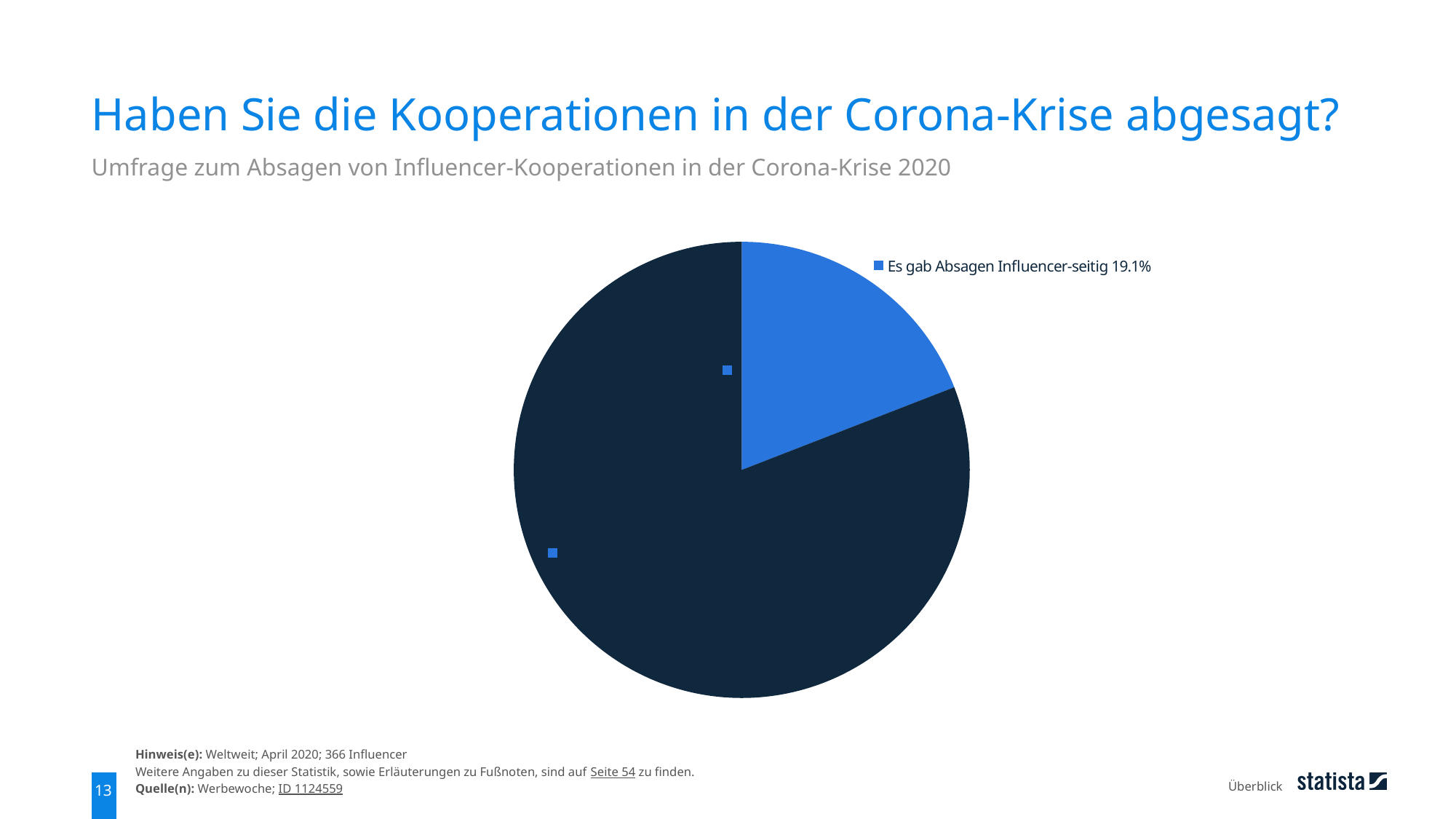
Is the slice "Es gab Absagen Influencer-seitig" the larger or the smaller slice of the pie? smaller Which slice is the largest in the pie chart, the light blue labeled slice or the dark navy unlabeled slice? the dark navy unlabeled slice What is the value printed for the slice "Es gab Absagen Influencer-seitig"? 19.1% What colour is the slice labeled "Es gab Absagen Influencer-seitig 19.1%"? light blue How many slices in the pie chart have a printed label? 1 What is the title of the slide containing the pie chart? Haben Sie die Kooperationen in der Corona-Krise abgesagt? How many slices does the pie chart have? 2 What share of the pie does the slice "Es gab Absagen Influencer-seitig" represent? 19.1% What kind of chart is shown on the slide? pie chart